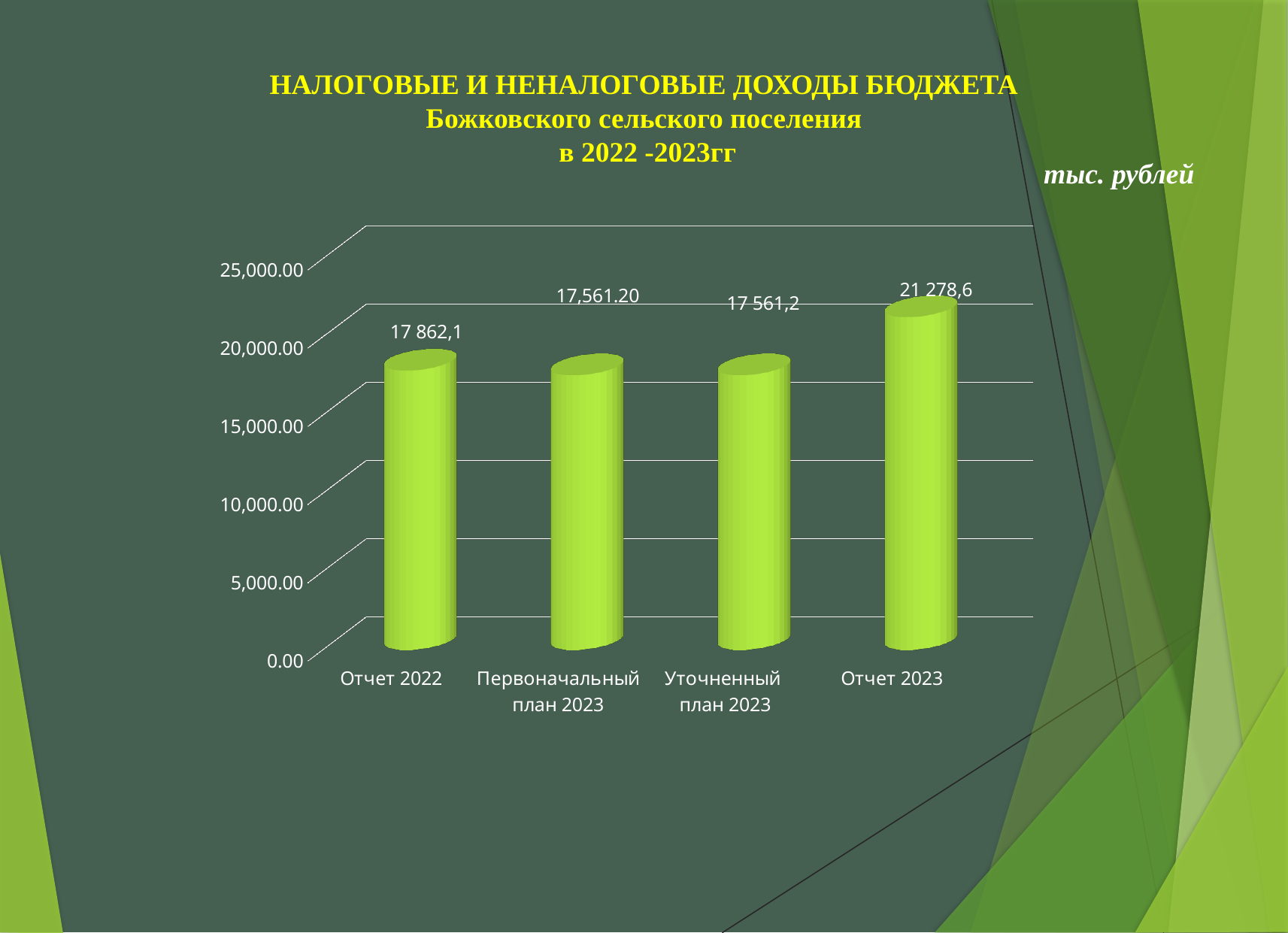
What is the value for Отчет 2022? 17 862,1 Is the value for Отчет 2023 greater or less than 20,000.00? greater How many categories are shown on the x axis? 4 What is the difference between the values for Отчет 2022 and Уточненный план 2023? 300,9 Which category has the highest value? Отчет 2023 What is the difference between the values for Отчет 2023 and Отчет 2022? 3 416,5 What kind of chart is shown on the slide? bar chart What is the value for Отчет 2023? 21 278,6 In what units are the values on the chart expressed, according to the slide? тыс. рублей Which is larger, the value for Отчет 2022 or the value for Первоначальный план 2023? Отчет 2022 What is the value for Первоначальный план 2023? 17,561.20 What is the value for Уточненный план 2023? 17 561,2